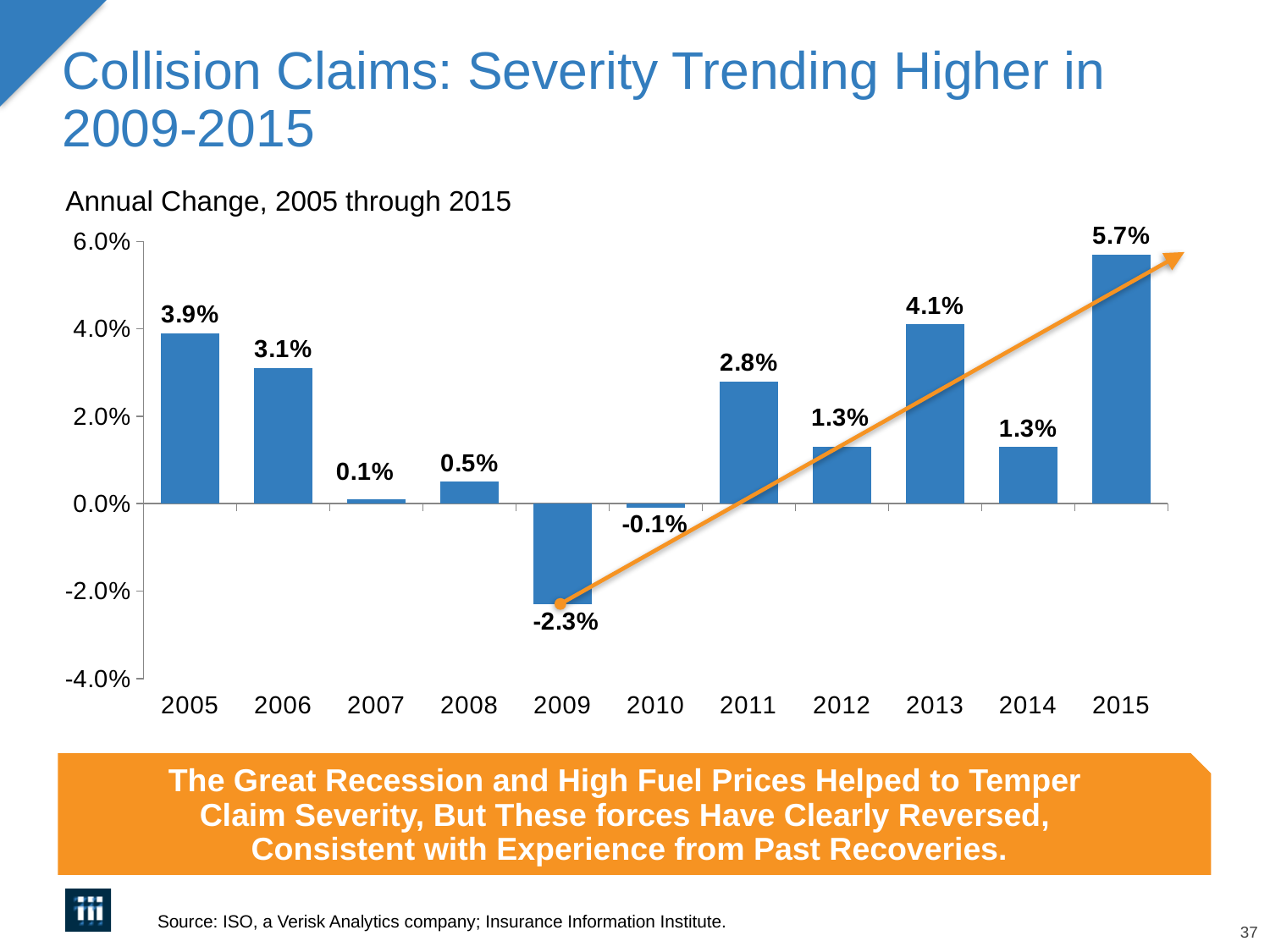
Which year has the larger value, 2005 or 2006? 2005 What kind of chart is shown on the slide? Bar chart How many years show a negative annual change? 2 What is the difference between the values for 2015 and 2013? 1.6% What is the annual change in collision claim severity for 2015? 5.7% How many years are shown on the x axis? 11 What is the value shown for 2011? 2.8% What is the subtitle printed above the chart? Annual Change, 2005 through 2015 Which year has the highest annual change? 2015 Do the values generally rise or fall from 2009 to 2015? Rise Which year has the lowest annual change? 2009 What is the annual change shown for 2009? -2.3%